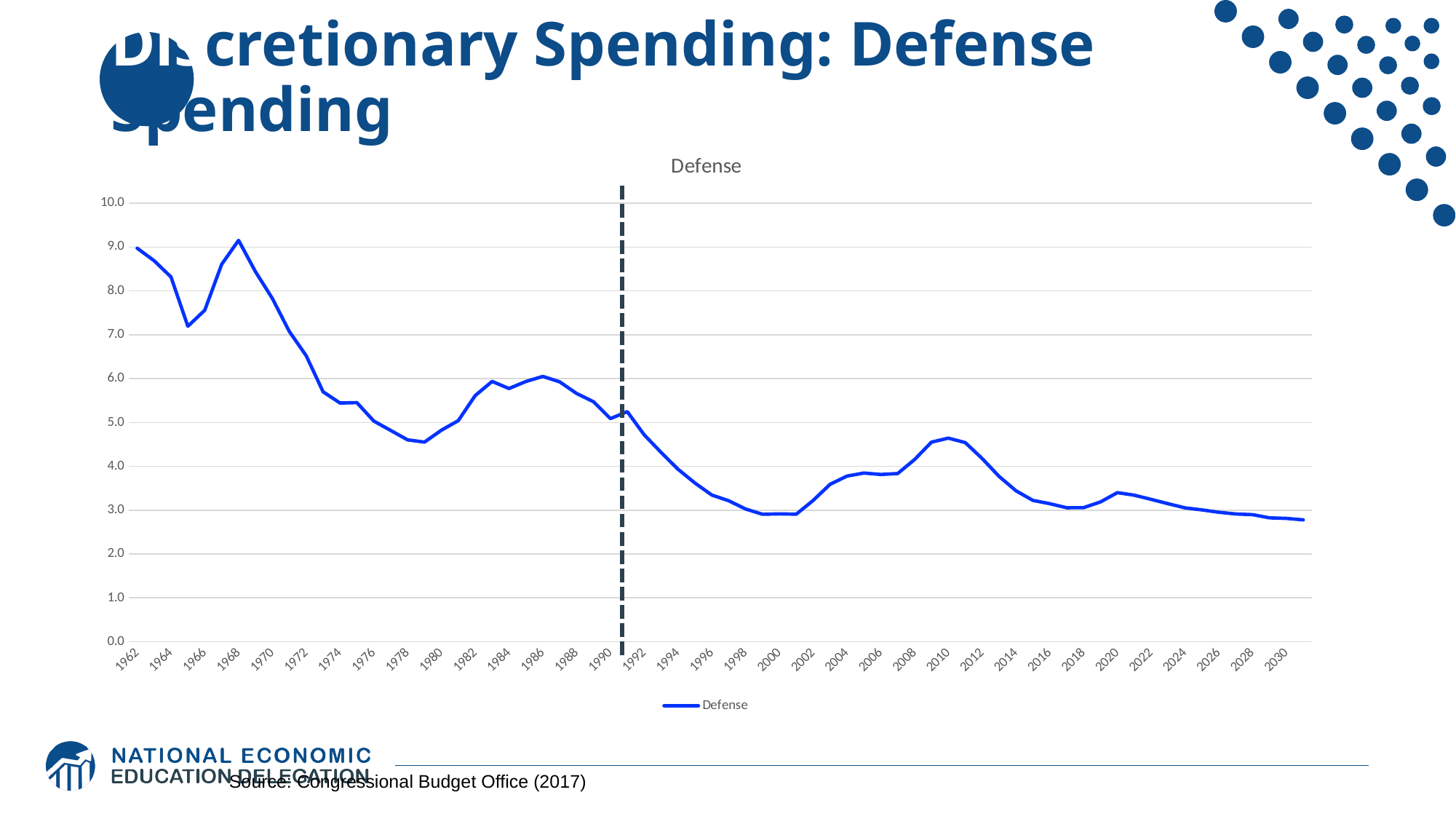
Overall, does the Defense line rise or fall from 1962 to 2030? fall Is the value for 1978 greater or less than 5.0? less Which year has the larger value, 1968 or 2010? 1968 Is the value for 2010 greater or less than 4.0? greater How many series does the legend list? 1 What is the name of the series shown in the legend? Defense Is the value for 1972 greater or less than 7.0? less What kind of chart is shown on the slide? line chart Does the Defense line rise or fall between 2000 and 2010? rise What is the title of the chart? Defense